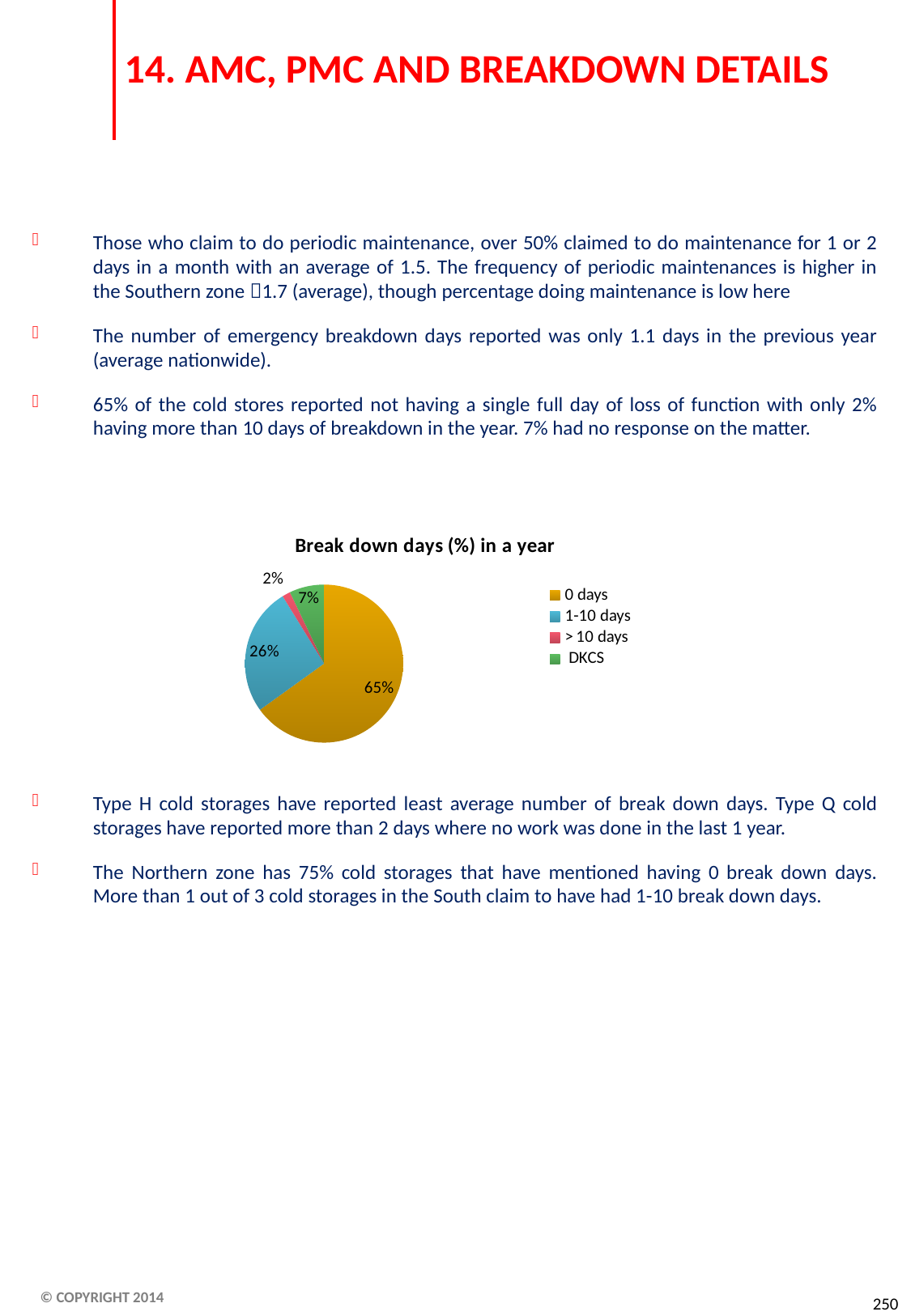
How many categories does the legend list? 4 What is the difference in percentage points between the 0 days slice and the 1-10 days slice? 39 Which category has the smallest share of the pie? > 10 days What is the title of the chart? Break down days (%) in a year What percentage of cold stores reported 0 break down days? 65% What percentage of cold stores reported > 10 break down days? 2% Which is larger, the share for 1-10 days or the share for DKCS? 1-10 days What kind of chart is shown on the slide? pie chart Which category has the largest share of the pie? 0 days What percentage is shown for the DKCS slice? 7% What percentage of cold stores reported 1-10 break down days? 26% What colour is the 0 days slice? gold/yellow